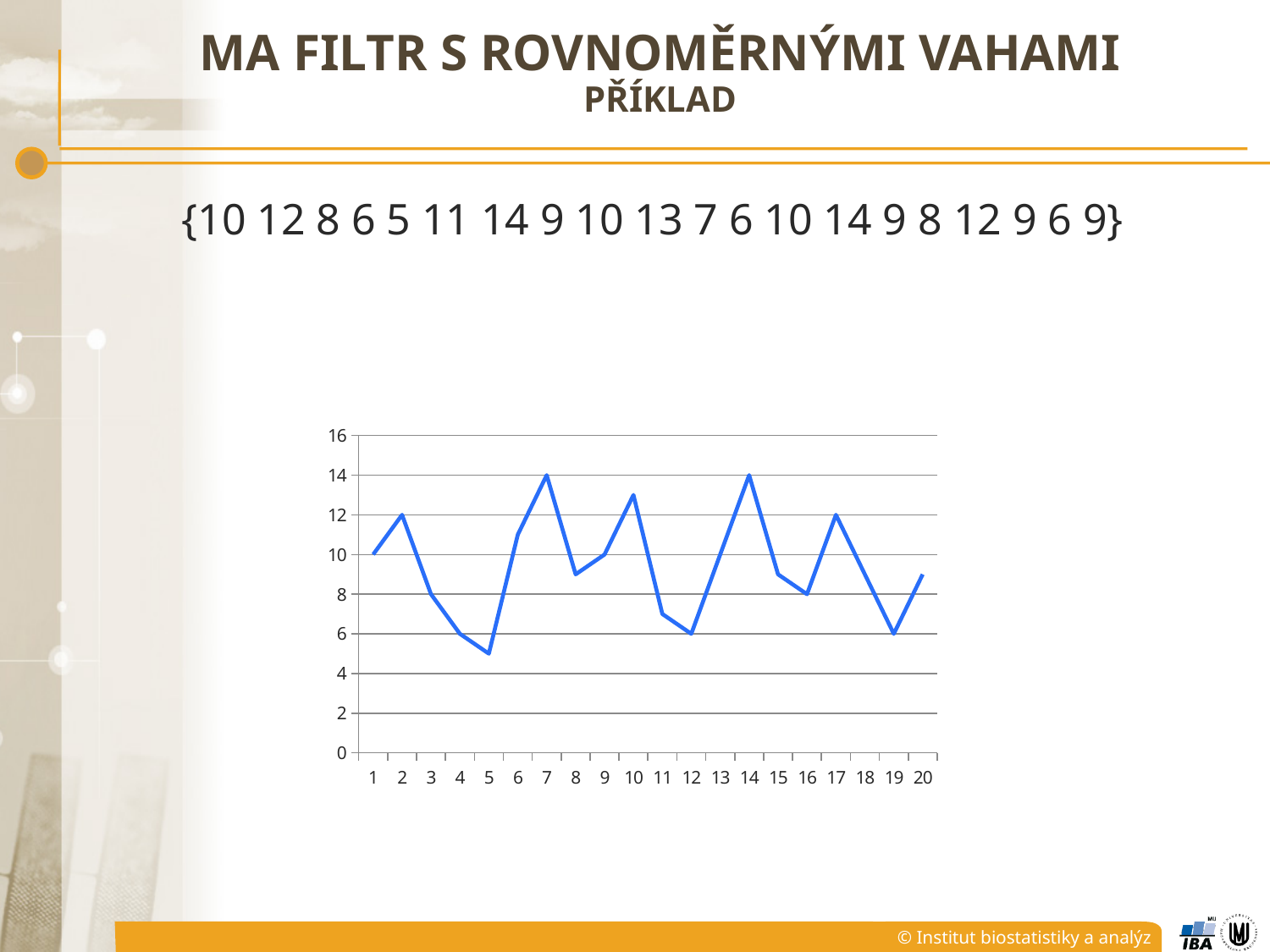
What is the value at x = 7 in the chart? 14 What is the value at x = 1 in the chart? 10 What is the difference between the value at x = 7 and the value at x = 4? 8 What is the value at x = 19 in the chart? 6 What is the value at x = 17 in the chart? 12 Does the line rise or fall between x = 4 and x = 5? fall At which x value does the line reach its lowest point? 5 What kind of chart is shown on the slide? line chart Is the value at x = 10 greater or less than 12? greater Which is larger, the value at x = 2 or the value at x = 3? x = 2 Is the value at x = 5 greater or less than 6? less How many points are plotted along the x axis of the chart? 20